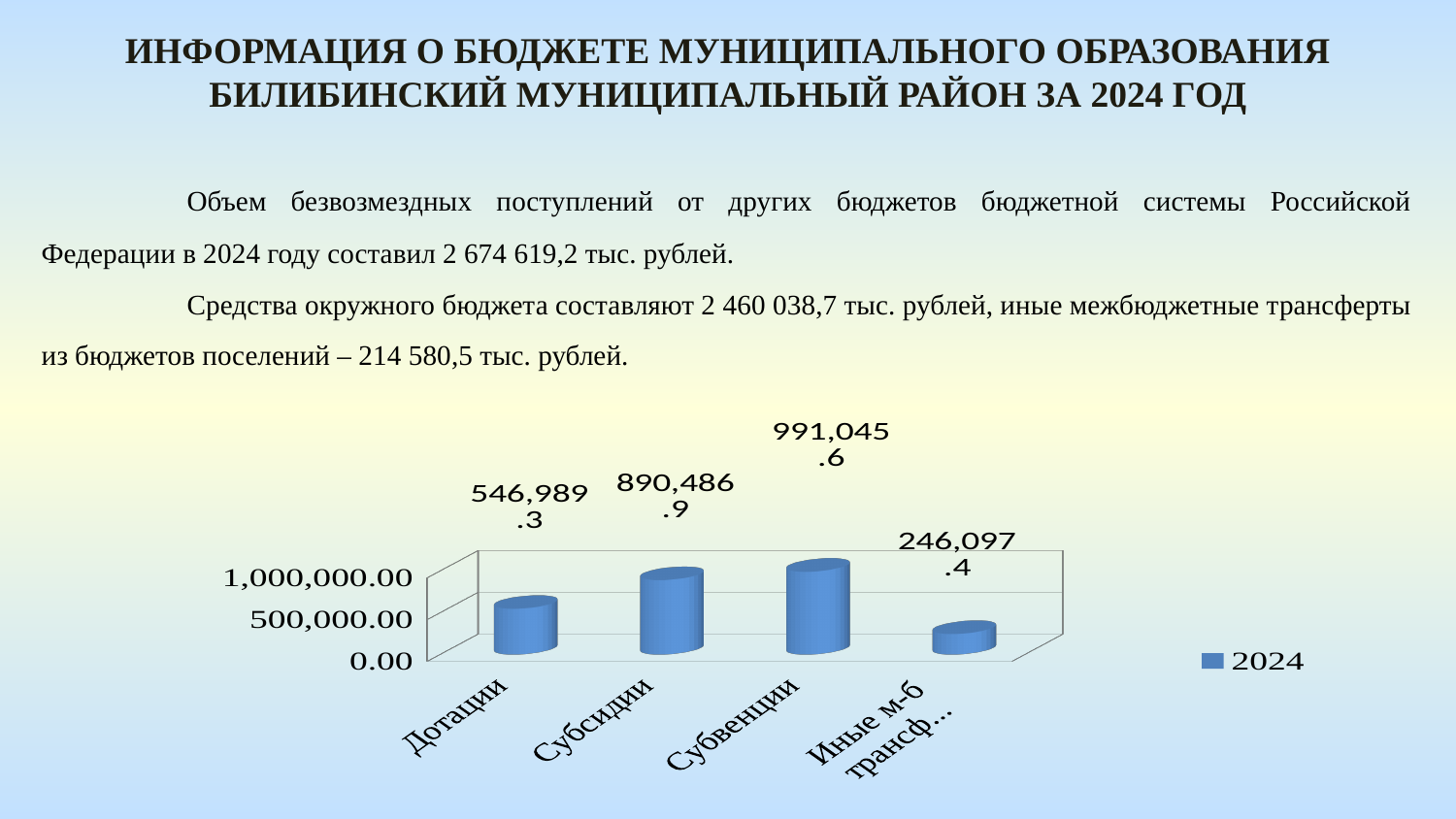
What is the value for Субвенции? 991,045.6 What kind of chart is shown on the slide? bar chart Which category has the highest value? Субвенции What is the difference between the values for Субсидии and Дотации? 343,497.6 How many categories are shown on the x axis of the chart? 4 What is the value for Субсидии? 890,486.9 What is the value for the category labelled "Иные м-б трансф..."? 246,097.4 What is the difference between the values for Субвенции and Субсидии? 100,558.7 How many series does the legend list? 1 Which is larger, the value for Дотации or the value for Субсидии? Субсидии Which category has the lowest value? Иные м-б трансф... What is the value for Дотации? 546,989.3